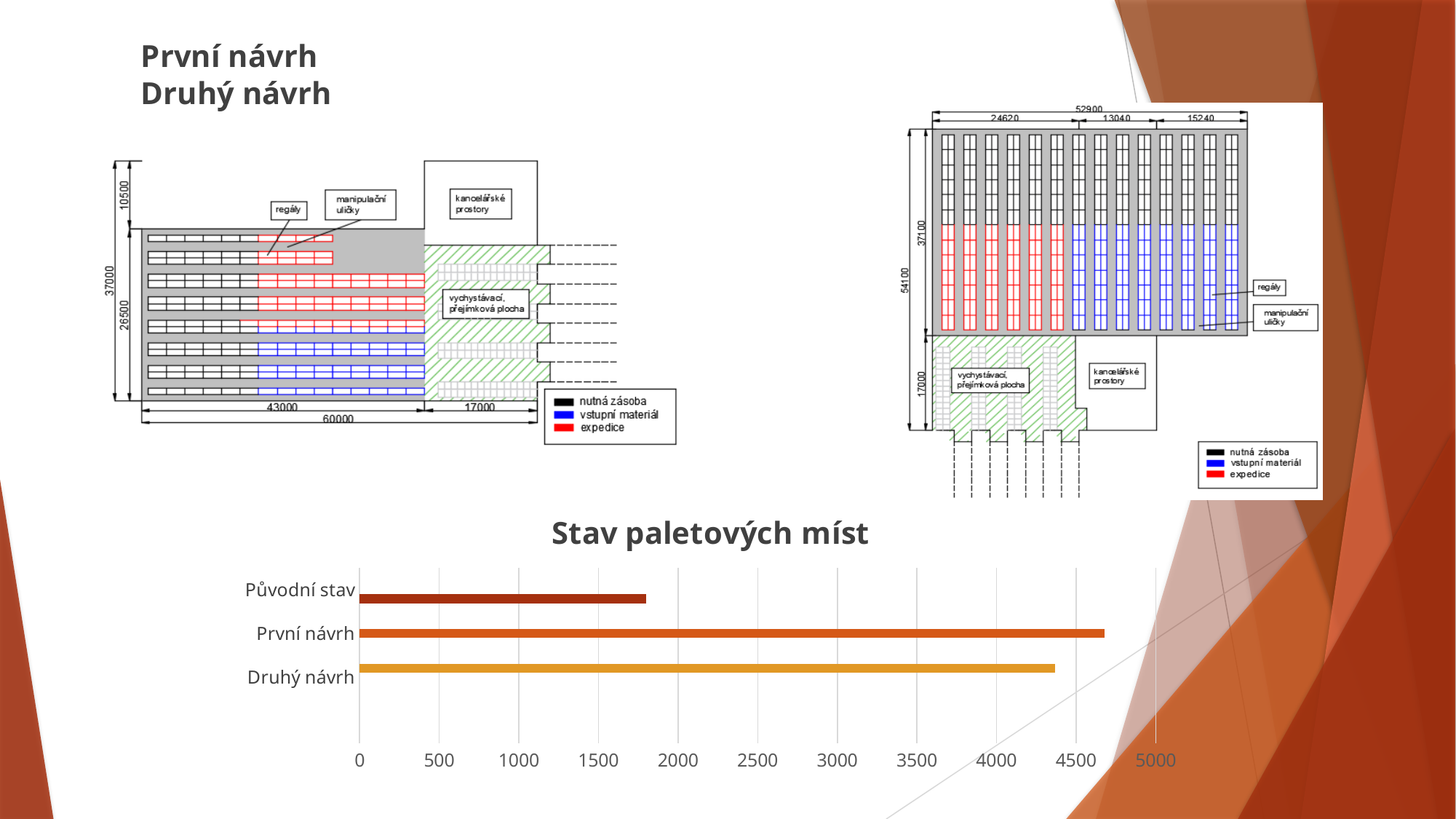
In the "Stav paletových míst" chart, is the value for Původní stav greater or less than 2000? less Which category has the highest value in the "Stav paletových míst" chart? První návrh In the "Stav paletových míst" chart, is the value for Původní stav greater or less than 1500? greater In the "Stav paletových míst" chart, is the value for První návrh greater or less than 4500? greater In the "Stav paletových míst" chart, which is larger: Původní stav or Druhý návrh? Druhý návrh Which category has the lowest value in the "Stav paletových míst" chart? Původní stav In the "Stav paletových míst" chart, which is larger: První návrh or Druhý návrh? První návrh What kind of chart is "Stav paletových míst"? bar chart How many categories are shown in the "Stav paletových míst" chart? 3 What is the title of the bar chart on the slide? Stav paletových míst